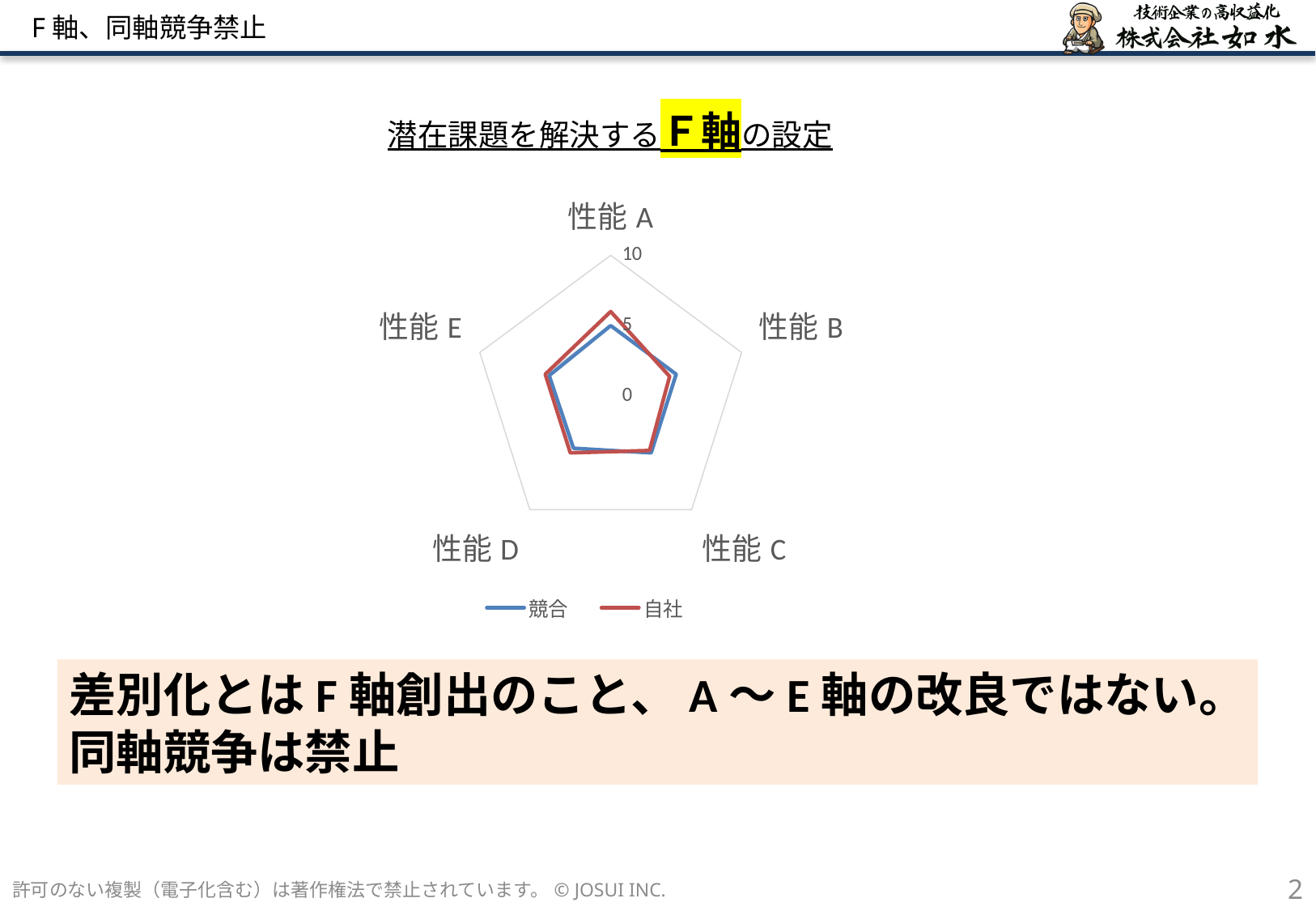
Is the value for 性能D in the 競合 series greater or less than 0? greater What kind of chart is shown on the slide? radar chart What is the maximum value shown on the radar chart's axis scale? 10 Is the value for 性能E in the 自社 series greater or less than 10? less What are the two series named in the legend of the radar chart? 競合 and 自社 Is the value for 性能C in the 自社 series greater or less than 10? less How many axes (categories) does the radar chart have? 5 Which colour represents the 自社 series in the radar chart? red How many series does the legend of the radar chart list? 2